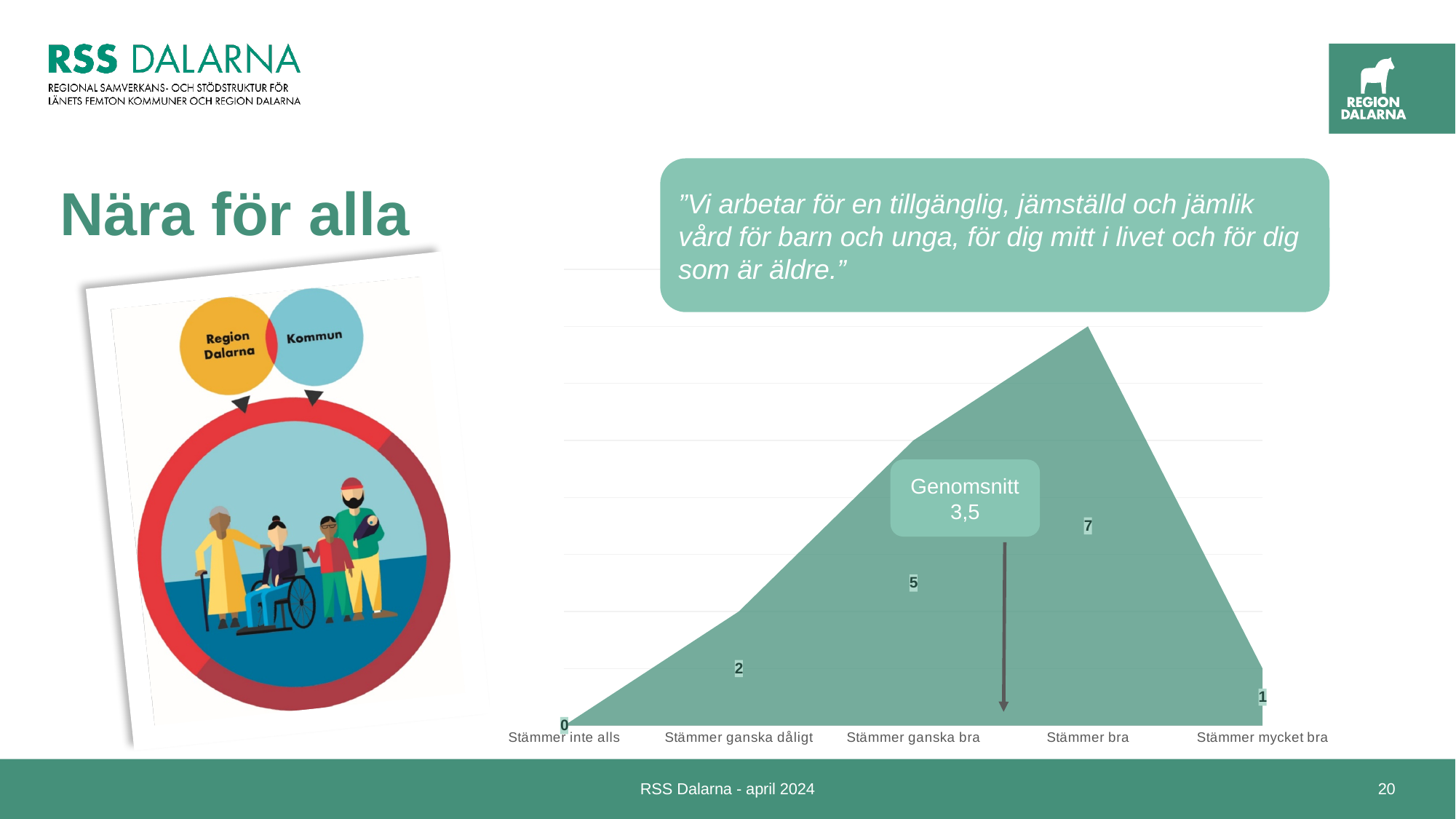
What is the value for "Stämmer ganska bra"? 5 Which is larger, the value for "Stämmer ganska dåligt" or the value for "Stämmer mycket bra"? Stämmer ganska dåligt What is the value for "Stämmer inte alls"? 0 What kind of chart is shown on the slide? Area chart Which category has the highest value? Stämmer bra What is the difference between the values for "Stämmer bra" and "Stämmer ganska bra"? 2 What average (Genomsnitt) value is annotated on the chart? 3,5 What is the value for "Stämmer mycket bra"? 1 Which category has the lowest value? Stämmer inte alls What is the value for "Stämmer ganska dåligt"? 2 How many categories are shown on the x axis? 5 What is the value for "Stämmer bra"? 7